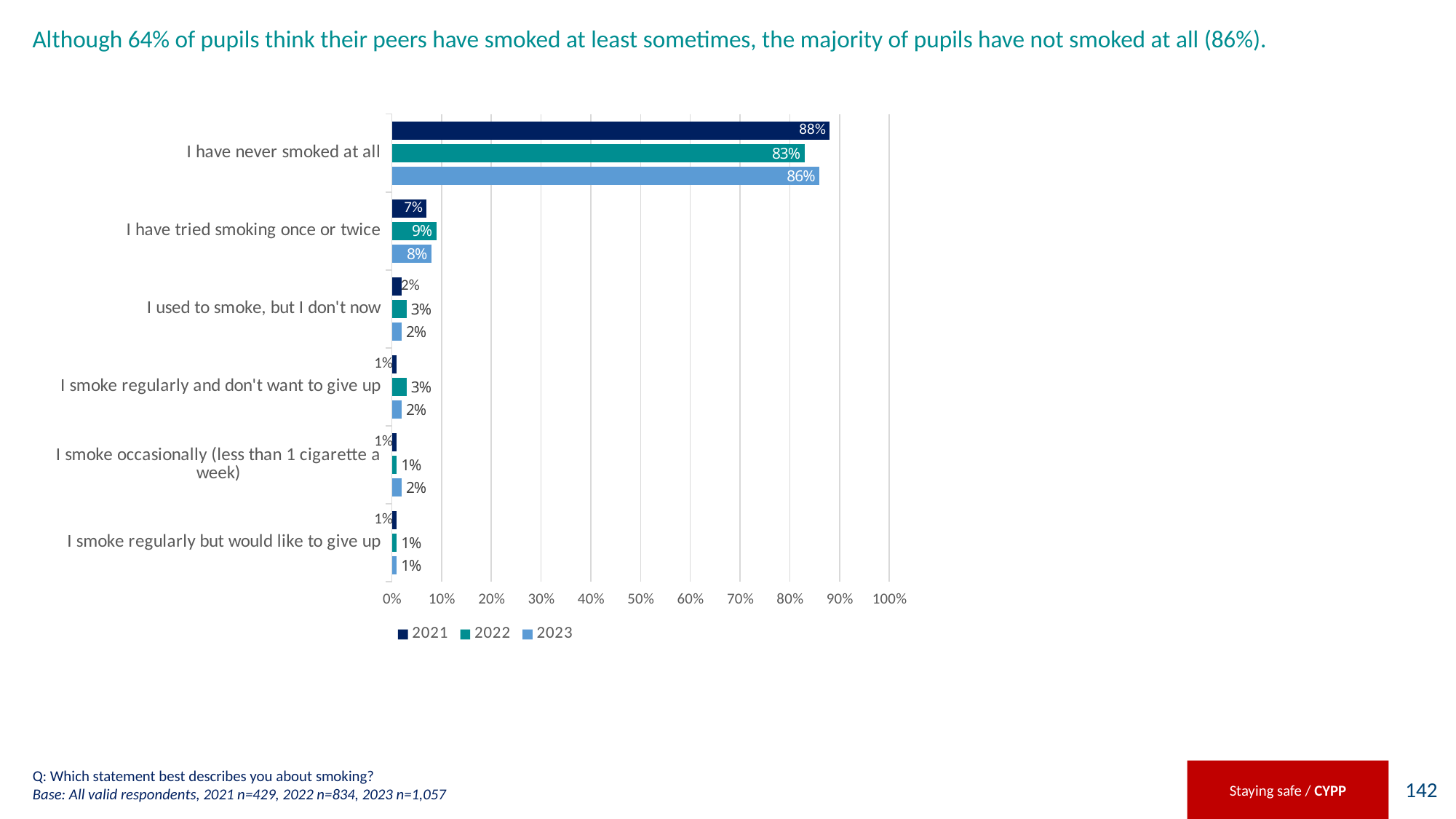
How many statements (categories) are shown on the chart? 6 Which is larger: the 2022 value or the 2023 value for 'I have tried smoking once or twice'? 2022 What was the value for 'I used to smoke, but I don't now' in 2021? 2% What is the difference between the 2021 and 2022 values for 'I have never smoked at all'? 5 percentage points Which years are listed in the chart legend? 2021, 2022, 2023 Which year had the highest value for 'I have never smoked at all'? 2021 What percentage of pupils said they have tried smoking once or twice in 2022? 9% What type of chart is shown on the slide? Bar chart Is the 2022 value for 'I have never smoked at all' greater or less than 80%? greater What percentage of pupils said they have never smoked at all in 2023? 86% How many series does the legend list? 3 Which statement had the highest percentage in 2023? I have never smoked at all